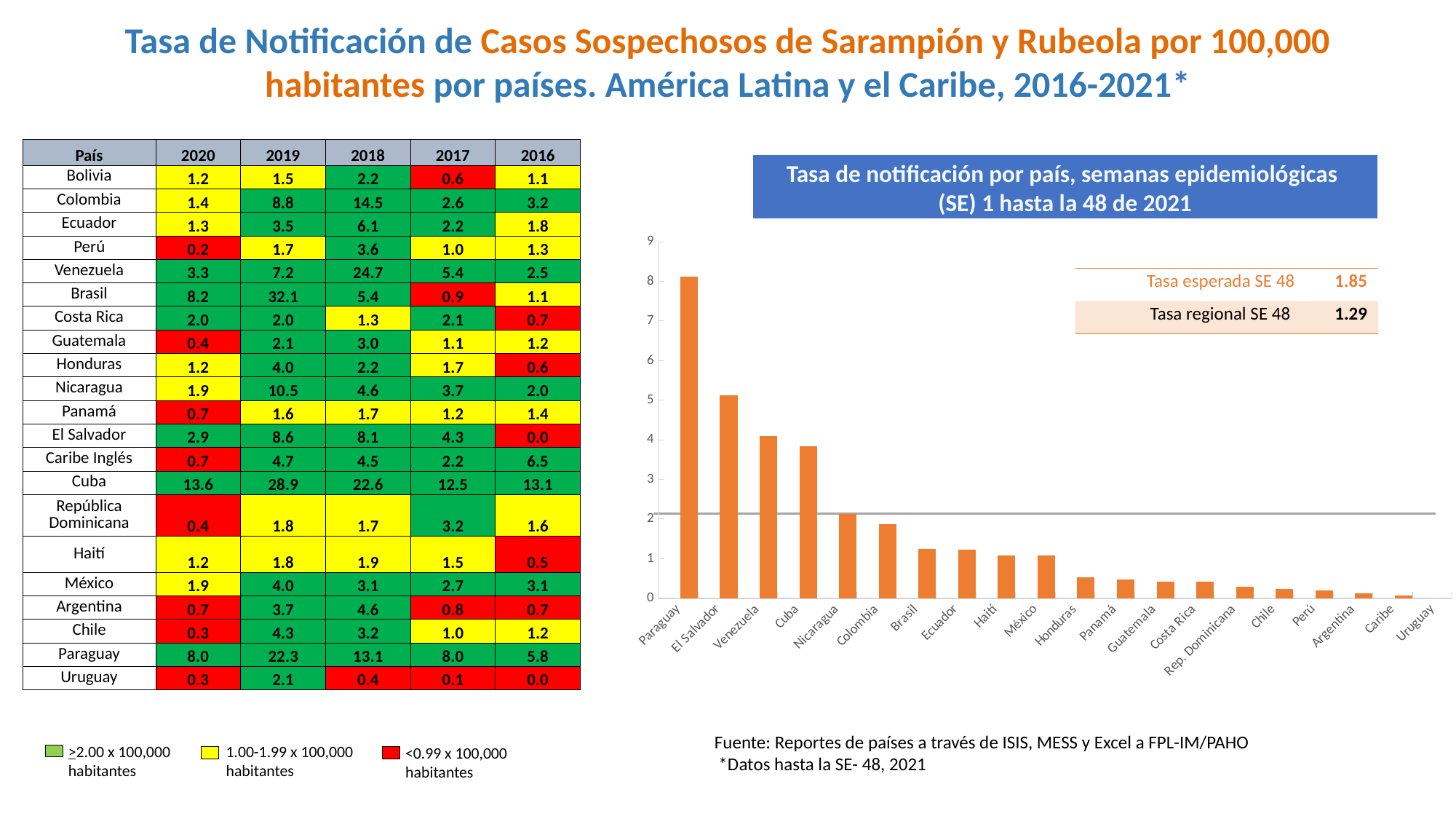
What is the 'Tasa esperada SE 48' shown in the box on the bar chart? 1.85 In the bar chart, do the values rise or fall moving from left to right along the x axis? fall How many countries are plotted in the bar chart 'Tasa de notificación por país'? 20 In the bar chart, is the value for Paraguay greater or less than 7? greater In the bar chart, which has a higher notification rate, Cuba or Nicaragua? Cuba In the bar chart, is the value for El Salvador greater or less than 4? greater In the bar chart, is the value for Nicaragua greater or less than 3? less What is the 'Tasa regional SE 48' shown in the box on the bar chart? 1.29 In the bar chart, which has a higher notification rate, Paraguay or El Salvador? Paraguay In the chart 'Tasa de notificación por país, semanas epidemiológicas (SE) 1 hasta la 48 de 2021', which country has the highest notification rate? Paraguay What kind of chart is shown on the right side of the slide? bar chart